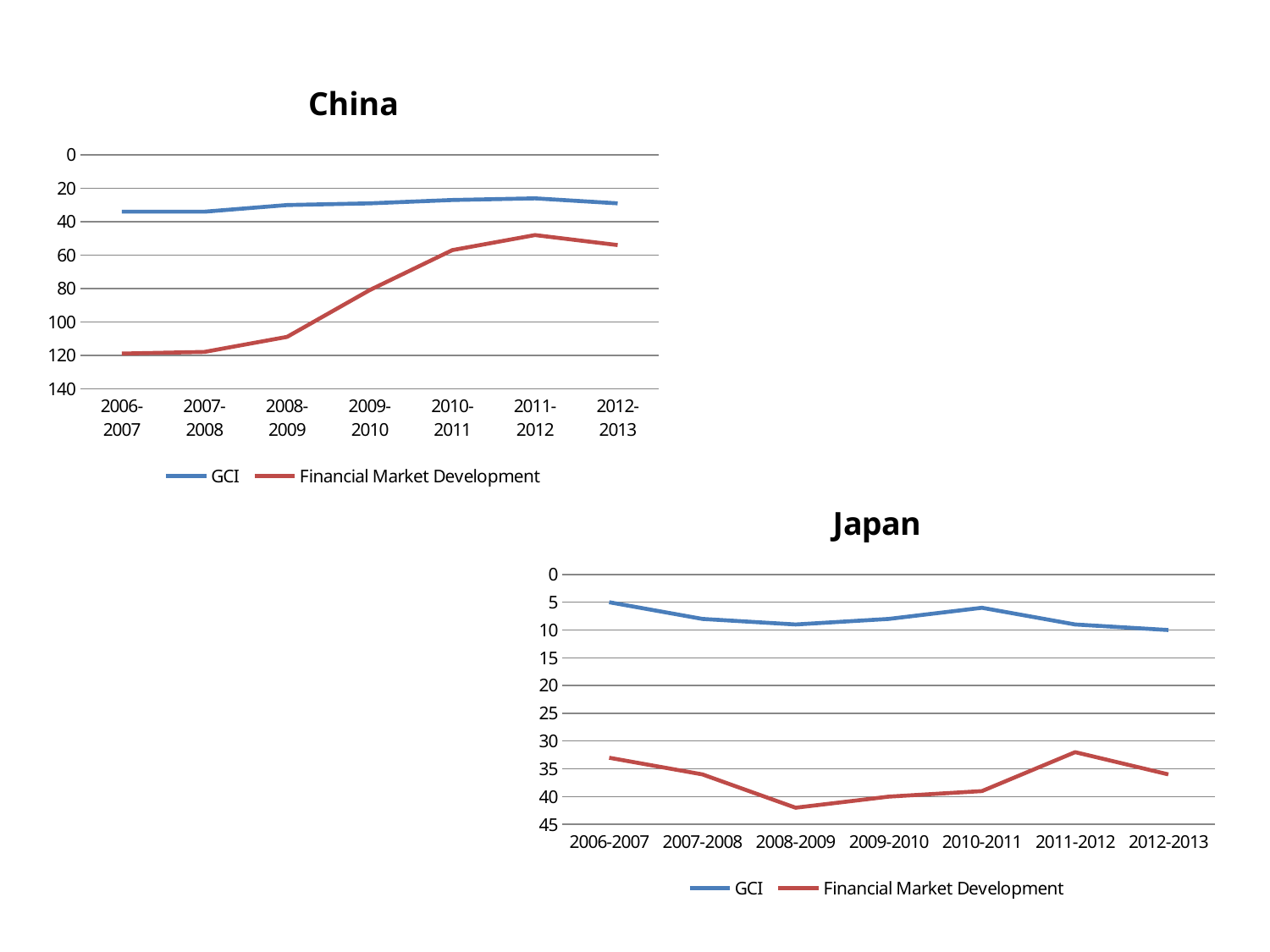
In the Japan chart, in which period is the Financial Market Development value highest? 2008-2009 In the China chart, which is larger, the Financial Market Development value for 2006-2007 or for 2011-2012? 2006-2007 In the China chart, in which period is the Financial Market Development value lowest? 2011-2012 In the Japan chart, is the GCI value for 2012-2013 greater or less than 5? greater In the Japan chart, is the Financial Market Development value for 2008-2009 greater or less than 40? greater How many periods are shown on the x axis of the China chart? 7 In the China chart, is the GCI value for 2011-2012 greater or less than 40? less In the China chart, do the Financial Market Development values rise or fall from 2007-2008 to 2011-2012? fall How many series does the legend of the Japan chart list? 2 What colour is the Financial Market Development line in the Japan chart? red What kind of chart is the China chart? line chart